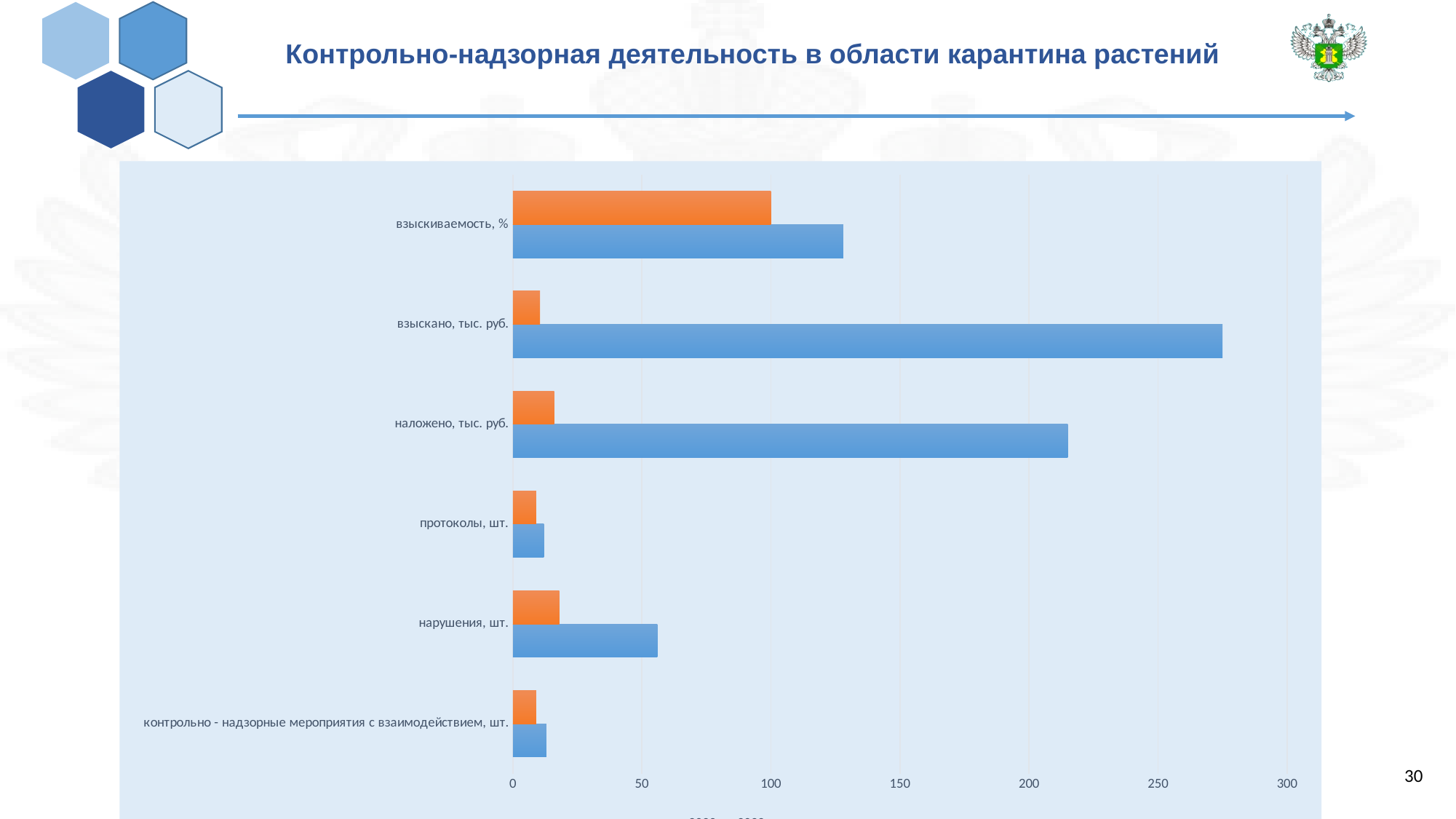
How many data series (bar colours) are plotted on the chart? 2 For 'взыскиваемость, %', which bar is longer, the orange one or the blue one? blue Is the orange bar for 'взыскиваемость, %' greater or less than 50? greater What kind of chart is shown on the slide? bar chart Is the blue bar for 'нарушения, шт.' greater or less than 50? greater Which category has the longest blue bar? взыскано, тыс. руб. What is the title of the slide containing the chart? Контрольно-надзорная деятельность в области карантина растений Is the blue bar for 'наложено, тыс. руб.' greater or less than 200? greater How many categories are plotted on the chart? 6 For 'наложено, тыс. руб.', which bar is longer, the orange one or the blue one? blue